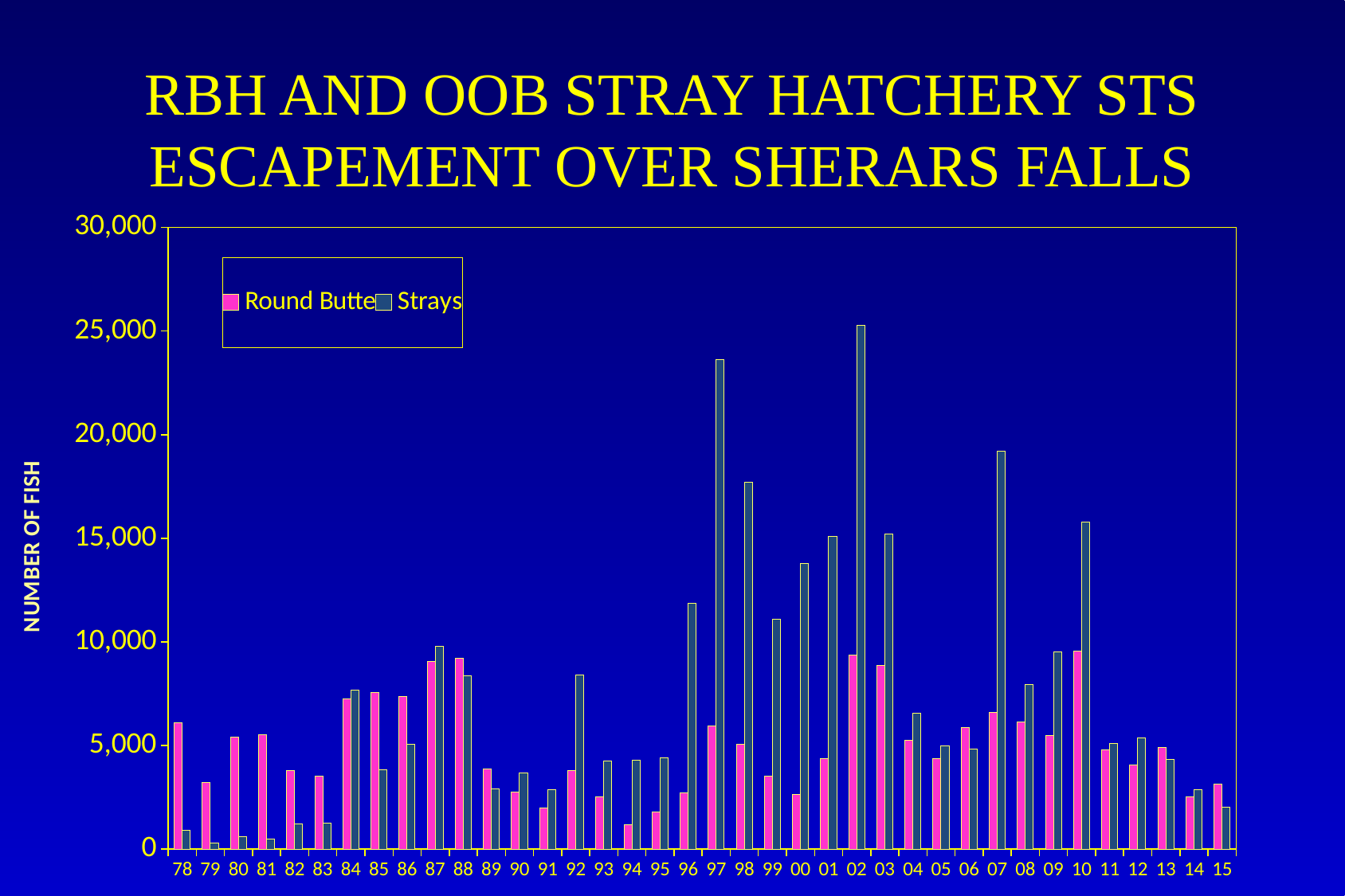
In which year is the Strays value lowest? 79 What kind of chart is shown on the slide? bar chart Is the Strays value for 78 greater or less than 5,000? less In which year is the Strays value highest? 02 How many series does the legend list? 2 Is the Round Butte value for 78 greater or less than 5,000? greater What is the title of the y axis? NUMBER OF FISH Is the Strays value for 07 greater or less than 15,000? greater In 97, which series has the larger value, Round Butte or Strays? Strays How many years are shown along the x axis? 38 In which year is the Round Butte value lowest? 94